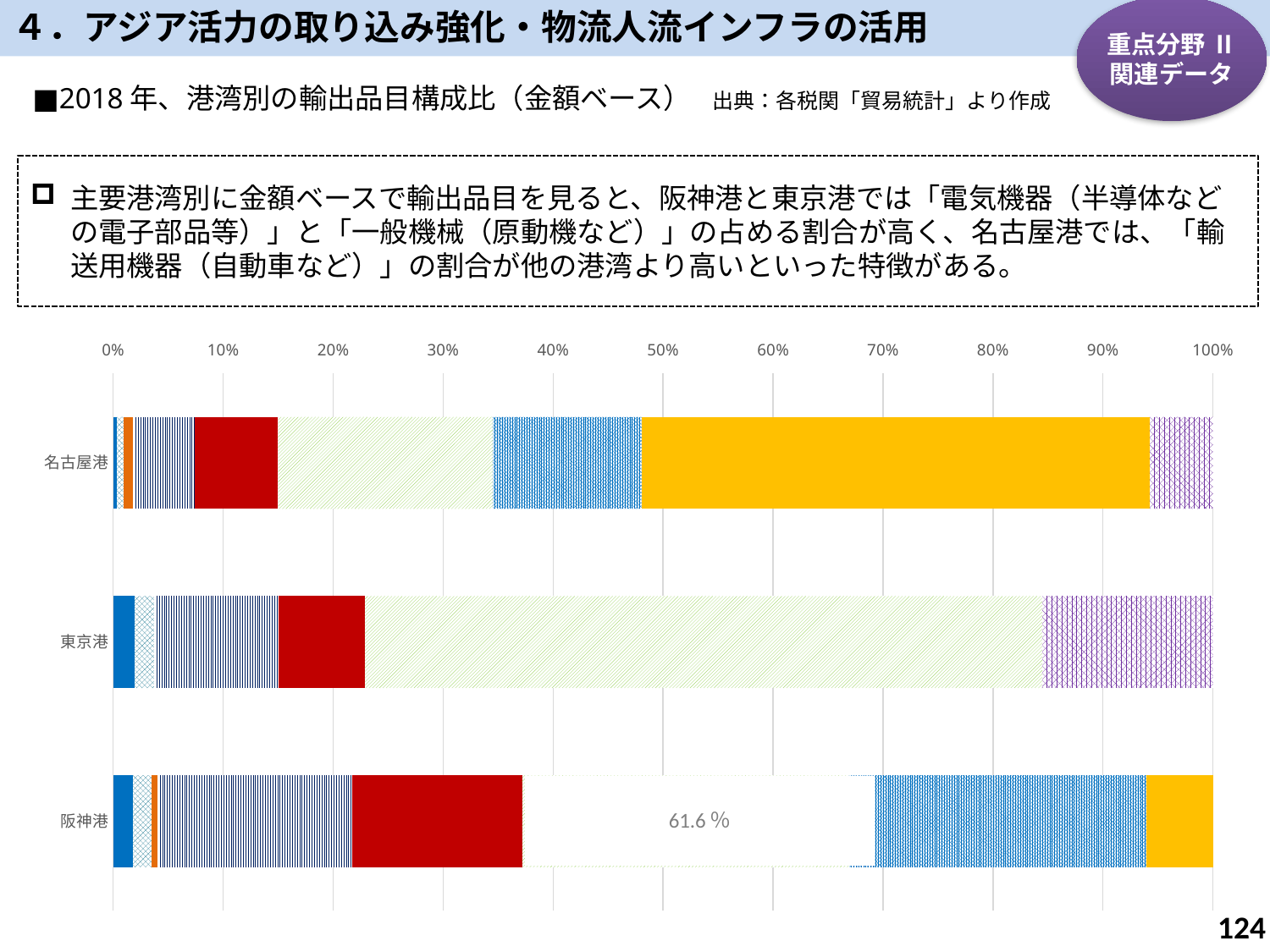
What data label is printed on the 阪神港 bar? 61.6% How many ports (categories) are plotted in the chart? 3 Which port has the largest yellow segment in its bar? 名古屋港 What is the maximum value shown on the horizontal axis? 100% Which port has the larger red segment, 阪神港 or 名古屋港? 阪神港 Is the green hatched segment for 東京港 greater or less than 50%? greater Does the 東京港 bar contain a yellow segment? No Which port has the largest red segment in its bar? 阪神港 Which port has the largest dark-blue vertically striped segment in its bar? 阪神港 Is the red segment for 名古屋港 greater or less than 10%? less What kind of chart is shown on the slide? bar chart Is the yellow segment for 名古屋港 greater or less than 40%? greater